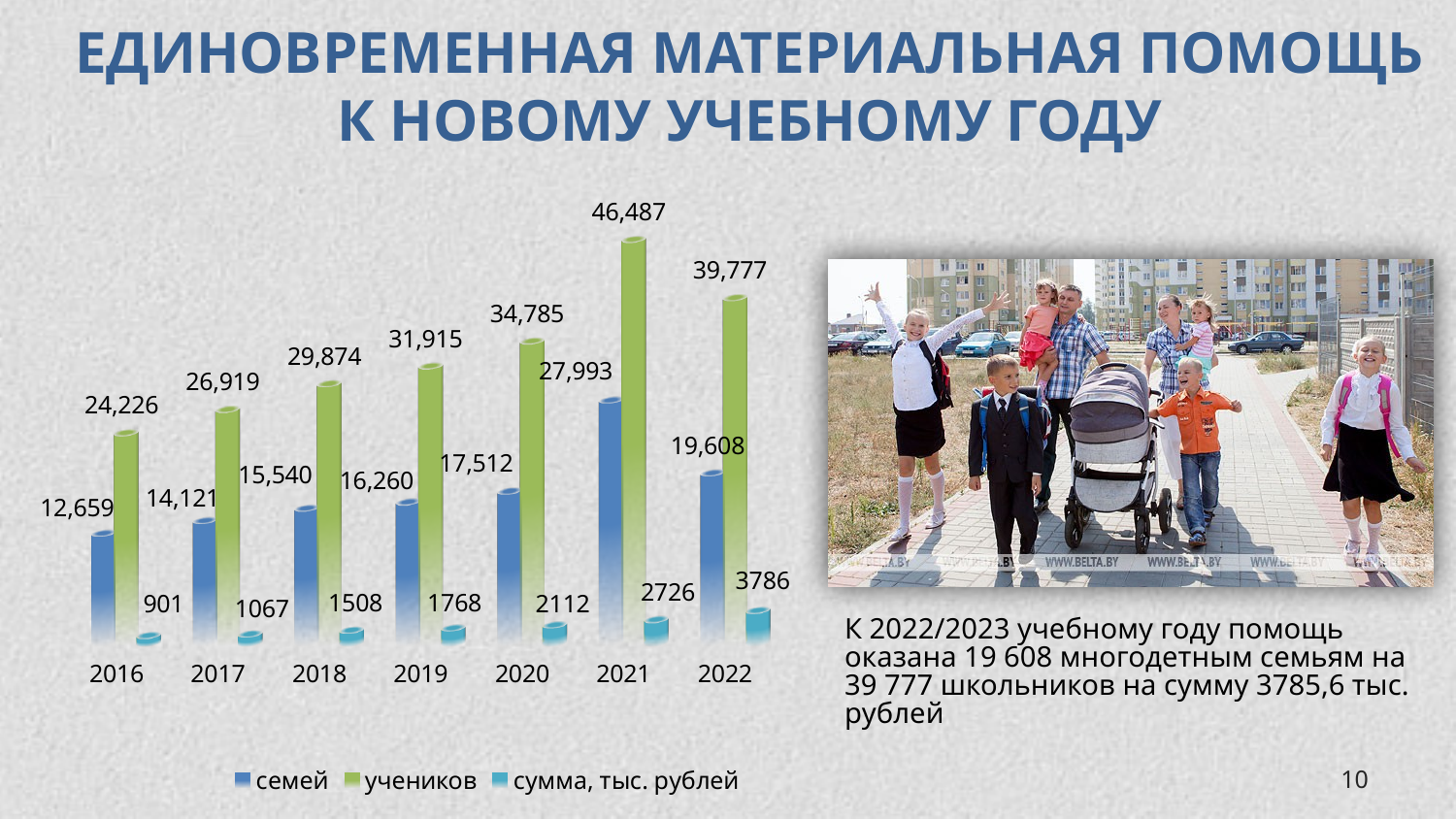
How many years are shown on the x axis of the chart? 7 What is the value of the 'учеников' series for 2021? 46,487 What kind of chart is shown on the slide? bar chart What is the difference between the 'учеников' values for 2021 and 2022? 6,710 How many series does the chart legend list? 3 In which year is the 'сумма, тыс. рублей' series lowest? 2016 Does the 'сумма, тыс. рублей' series rise or fall from 2016 to 2022? rise Which is larger: the 'семей' value for 2021 or for 2022? 2021 What is the value of the 'сумма, тыс. рублей' series for 2022? 3786 In which year is the 'учеников' series highest? 2021 Which series in the chart is shown in green? учеников What is the value of the 'семей' series for 2016? 12,659